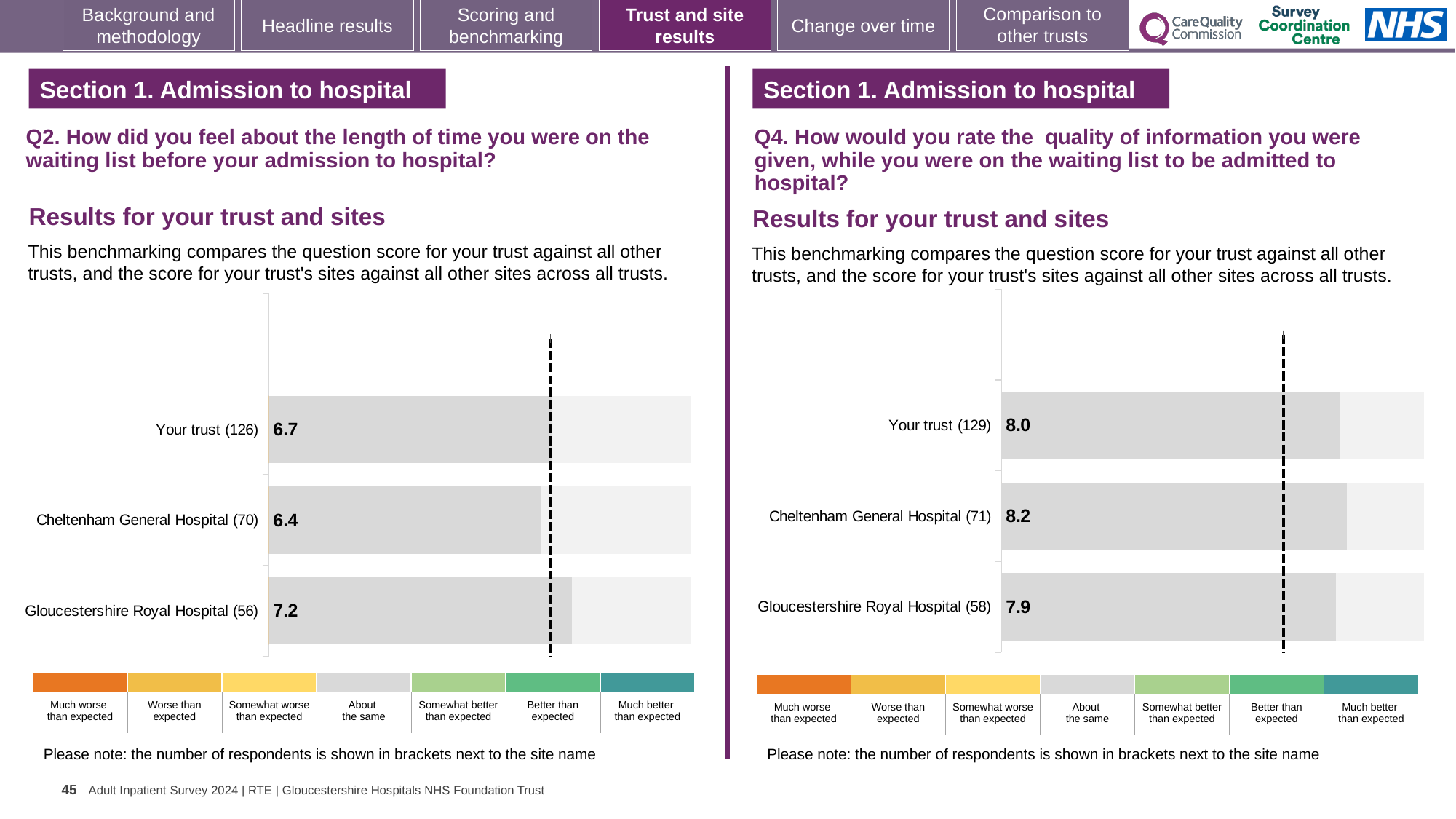
What type of chart is used in the Q2 chart on the left? Bar chart In the Q2 chart on the left, which site or trust has the lowest score? Cheltenham General Hospital In the Q4 chart on the right, what is the score for Gloucestershire Royal Hospital? 7.9 In the Q2 chart on the left, what is the score for Your trust? 6.7 In the Q2 chart on the left, which site or trust has the highest score? Gloucestershire Royal Hospital In the Q4 chart on the right, what is the score for Cheltenham General Hospital? 8.2 In the Q2 chart on the left, what is the score for Cheltenham General Hospital? 6.4 In the Q2 chart on the left, what is the difference between the scores for Gloucestershire Royal Hospital and Cheltenham General Hospital? 0.8 In the Q4 chart on the right, what is the difference between the scores for Your trust and Gloucestershire Royal Hospital? 0.1 In the Q2 chart on the left, how many respondents are shown in brackets for Your trust? 126 In the Q4 chart on the right, which site or trust has the highest score? Cheltenham General Hospital How many bars are plotted in the Q4 chart on the right? 3